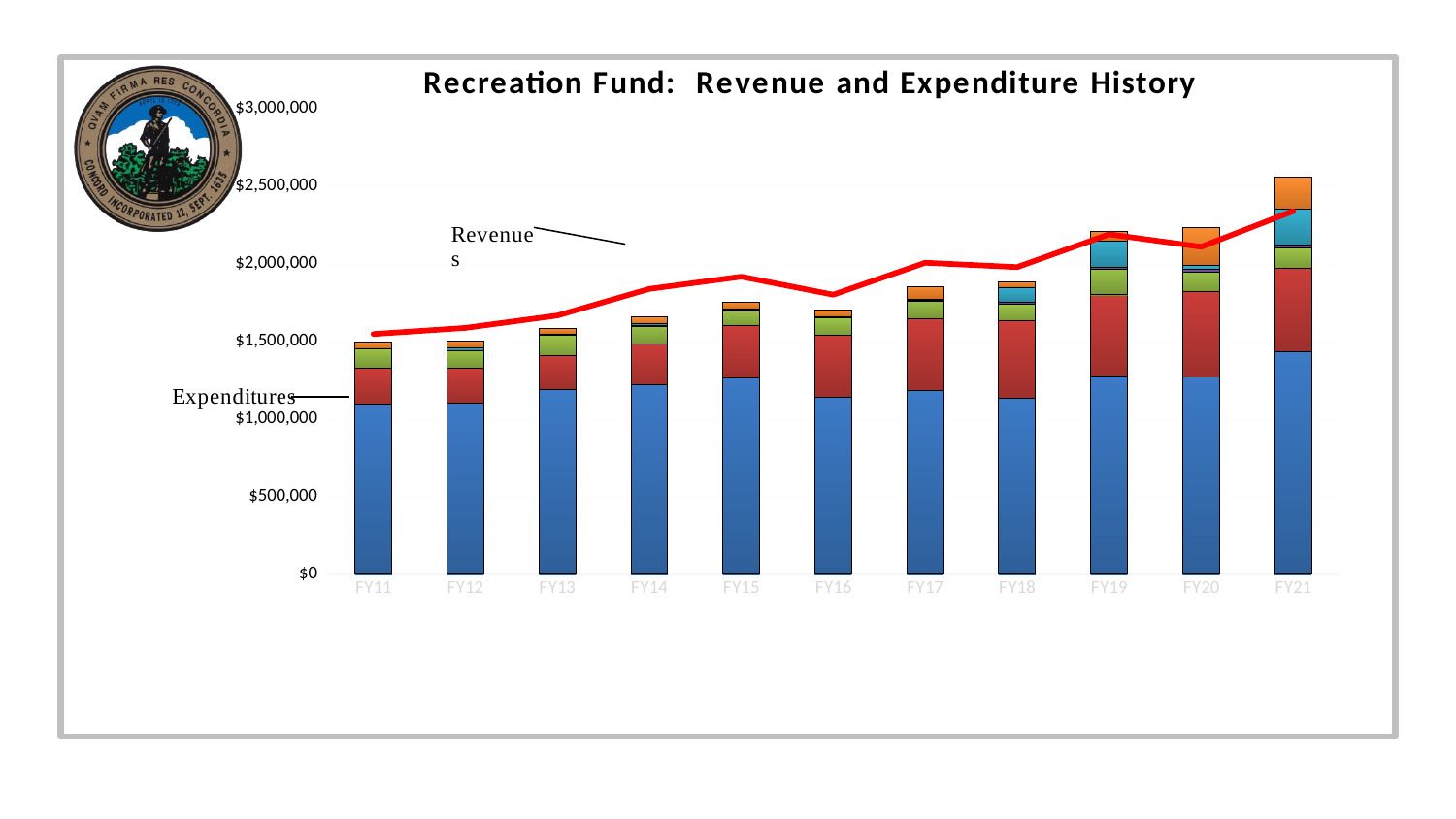
How many fiscal years are shown on the x axis? 11 Is the Revenues value for FY16 greater or less than $2,000,000? less Is the Revenues value for FY21 greater or less than $2,000,000? greater What does the red line represent? Revenues What is the title of the chart? Recreation Fund: Revenue and Expenditure History Is the total stacked bar for FY21 greater or less than $2,000,000? greater What kind of chart is shown on the slide? Stacked bar chart with a line Which fiscal year has the tallest stacked bar? FY21 Does the Revenues line generally rise or fall from FY11 to FY21? rise Which is larger, the total stacked bar for FY21 or for FY11? FY21 Which is larger, the Revenues value for FY21 or for FY16? FY21